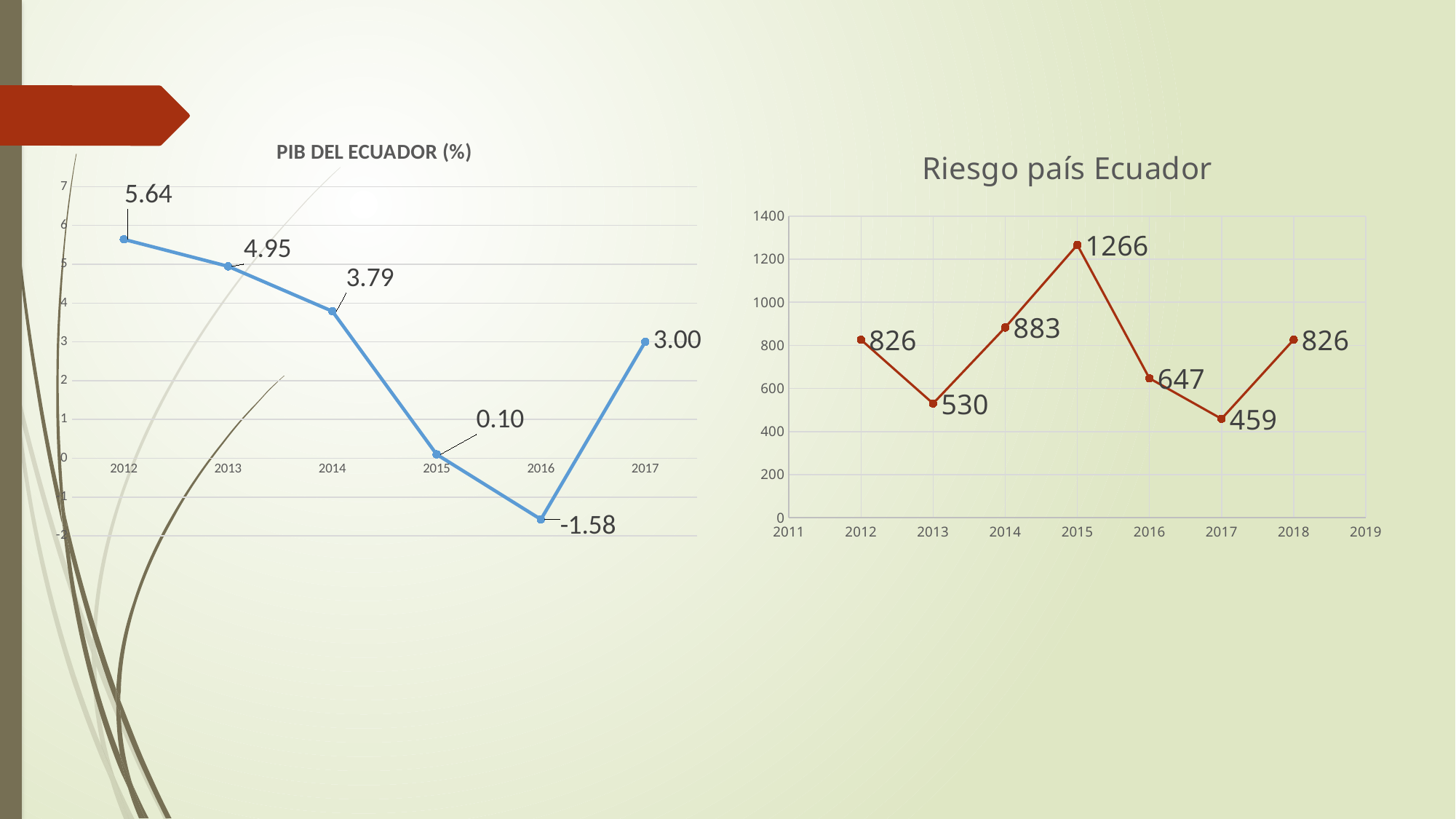
In the 'Riesgo país Ecuador' chart, what is the difference between the 2015 value and the 2016 value? 619 In the 'PIB DEL ECUADOR (%)' chart, what is the difference between the 2013 value and the 2014 value? 1.16 In the 'PIB DEL ECUADOR (%)' chart, which year has the lowest value? 2016 In the 'Riesgo país Ecuador' chart, which year has the lowest value? 2017 In the 'Riesgo país Ecuador' chart, what is the value for 2015? 1266 What type of chart is the 'Riesgo país Ecuador' chart? line chart In the 'PIB DEL ECUADOR (%)' chart, how many years are plotted? 6 In the 'Riesgo país Ecuador' chart, which is larger, the value for 2014 or the value for 2013? 2014 In the 'PIB DEL ECUADOR (%)' chart, do the values rise or fall from 2012 to 2016? fall In the 'PIB DEL ECUADOR (%)' chart, what is the value for 2012? 5.64 In the 'PIB DEL ECUADOR (%)' chart, which year has the highest value? 2012 In the 'PIB DEL ECUADOR (%)' chart, what is the value for 2016? -1.58